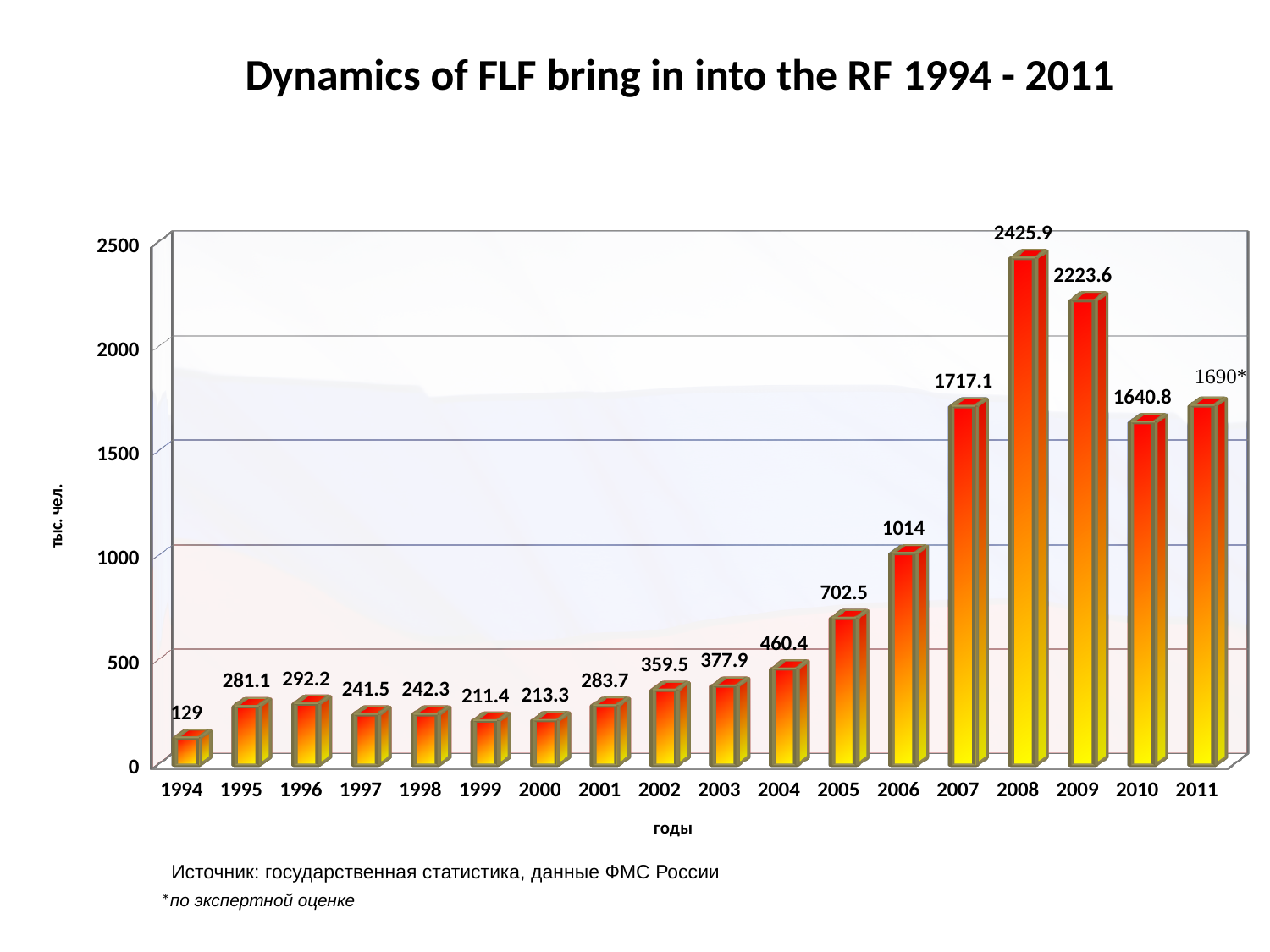
Which is larger, the value for 2007 or the value for 2010? 2007 What kind of chart is this? bar chart What is the value for 2011? 1690* Which year has the lowest value? 1994 What is the value for 2008? 2425.9 What is the value for 1994? 129 Is the value for 2005 greater or less than 500? greater What is the value for 2006? 1014 What is the title of the chart? Dynamics of FLF bring in into the RF 1994 - 2011 How many years are shown on the x axis? 18 Which year has the highest value? 2008 What is the difference between the values for 2008 and 2009? 202.3